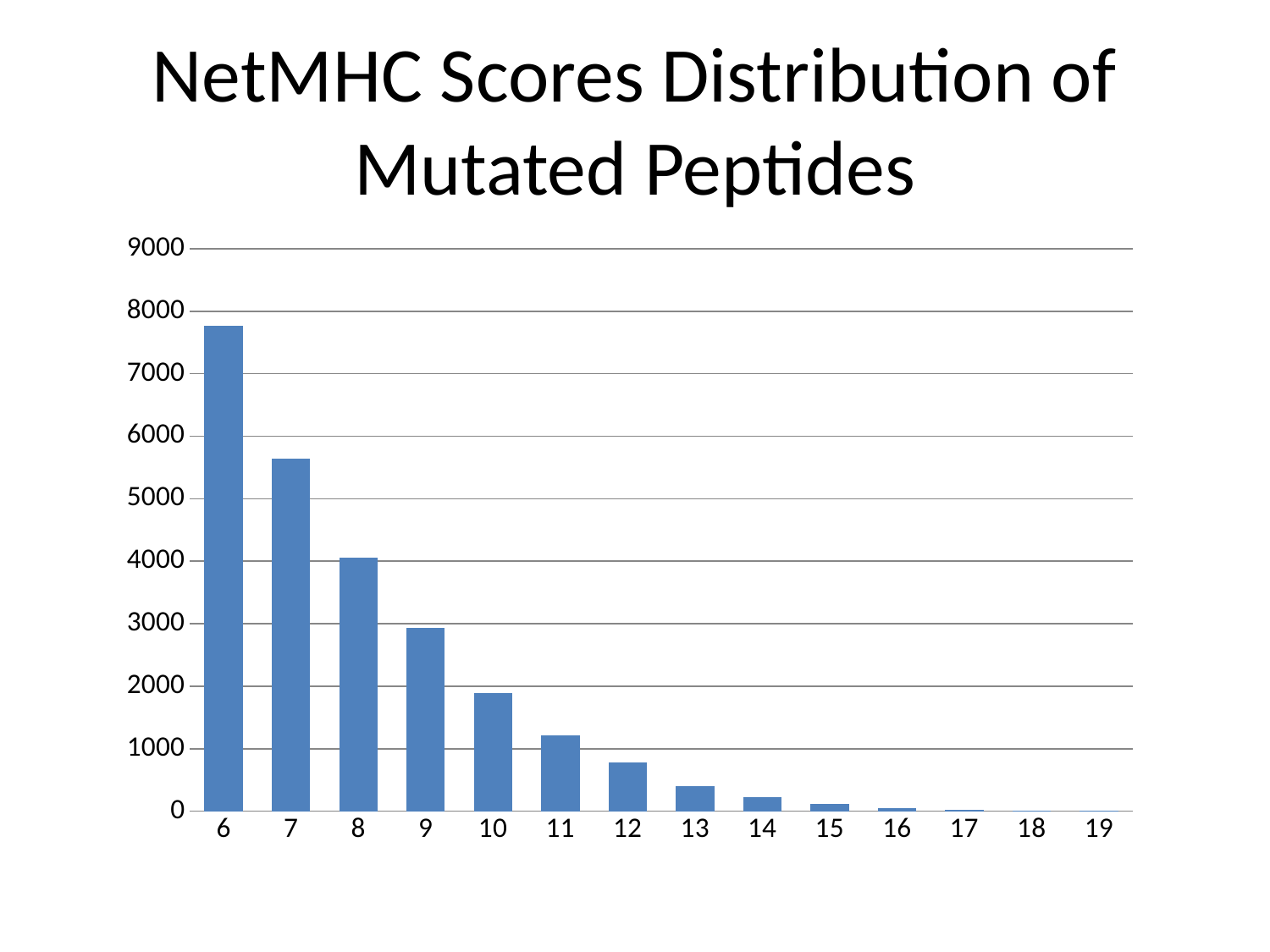
What is the title of the chart? NetMHC Scores Distribution of Mutated Peptides How many categories are shown on the x axis? 14 Is the value for category 12 greater or less than 1000? less Is the value for category 10 greater or less than 2000? less Do the values rise or fall as the x axis goes from 6 to 19? fall Which category has the highest value? 6 Is the value for category 7 greater or less than 5000? greater Which has the larger value, category 7 or category 8? 7 What type of chart is shown on the slide? bar chart